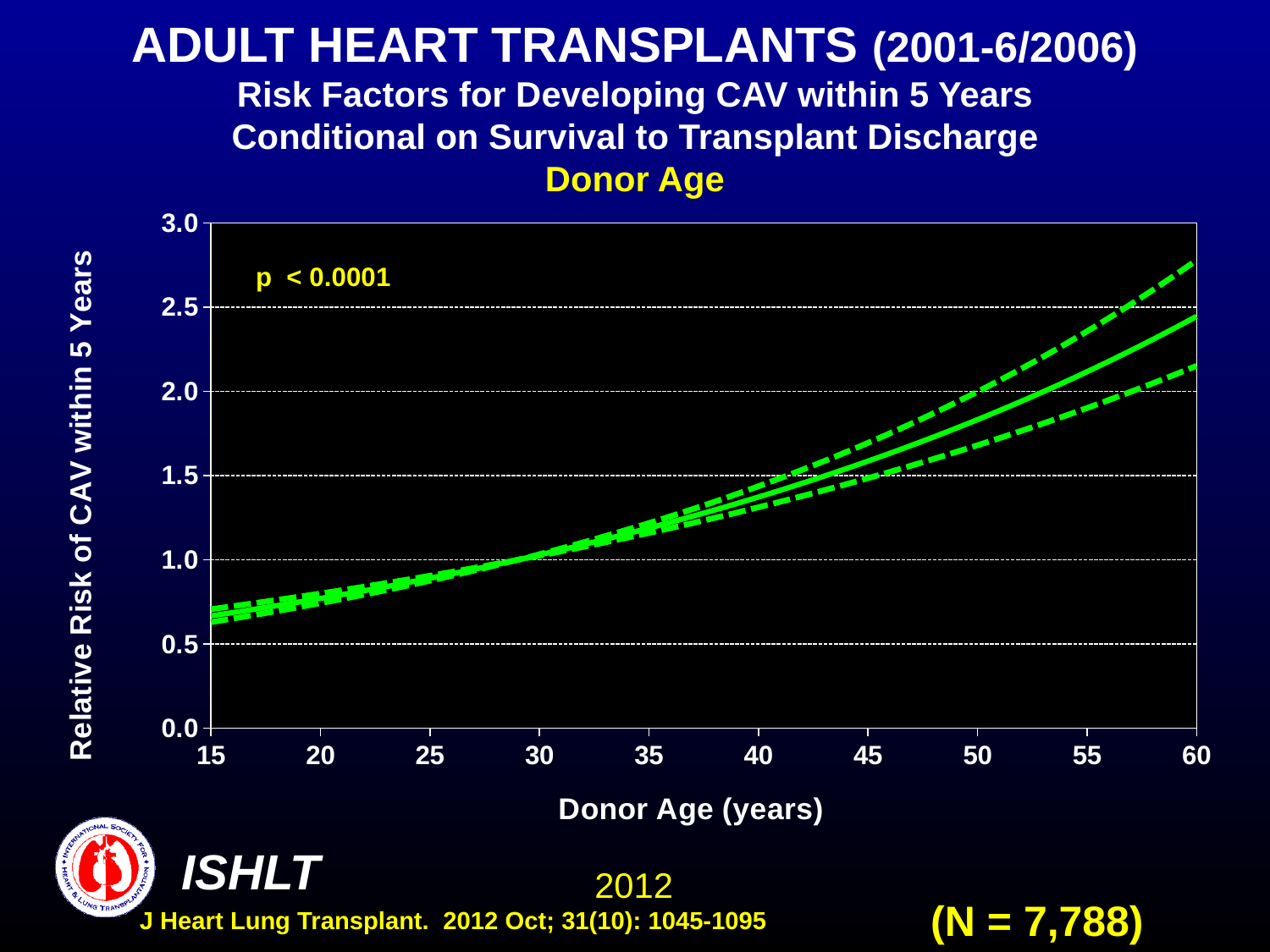
Is the relative risk shown by the solid line at donor age 40 greater or less than 1.5? less Is the relative risk shown by the solid line at donor age 60 greater or less than 2.0? greater Is the relative risk shown by the solid line at donor age 15 greater or less than 1.0? less What is the label of the x axis? Donor Age (years) Is the relative risk at donor age 60 higher or lower than at donor age 15? higher How many lines (solid and dashed) are plotted on the chart? 3 Does the relative risk of CAV rise or fall as donor age increases from 15 to 60 years? rise What p-value is printed on the chart? p < 0.0001 What kind of chart is shown on the slide? line chart